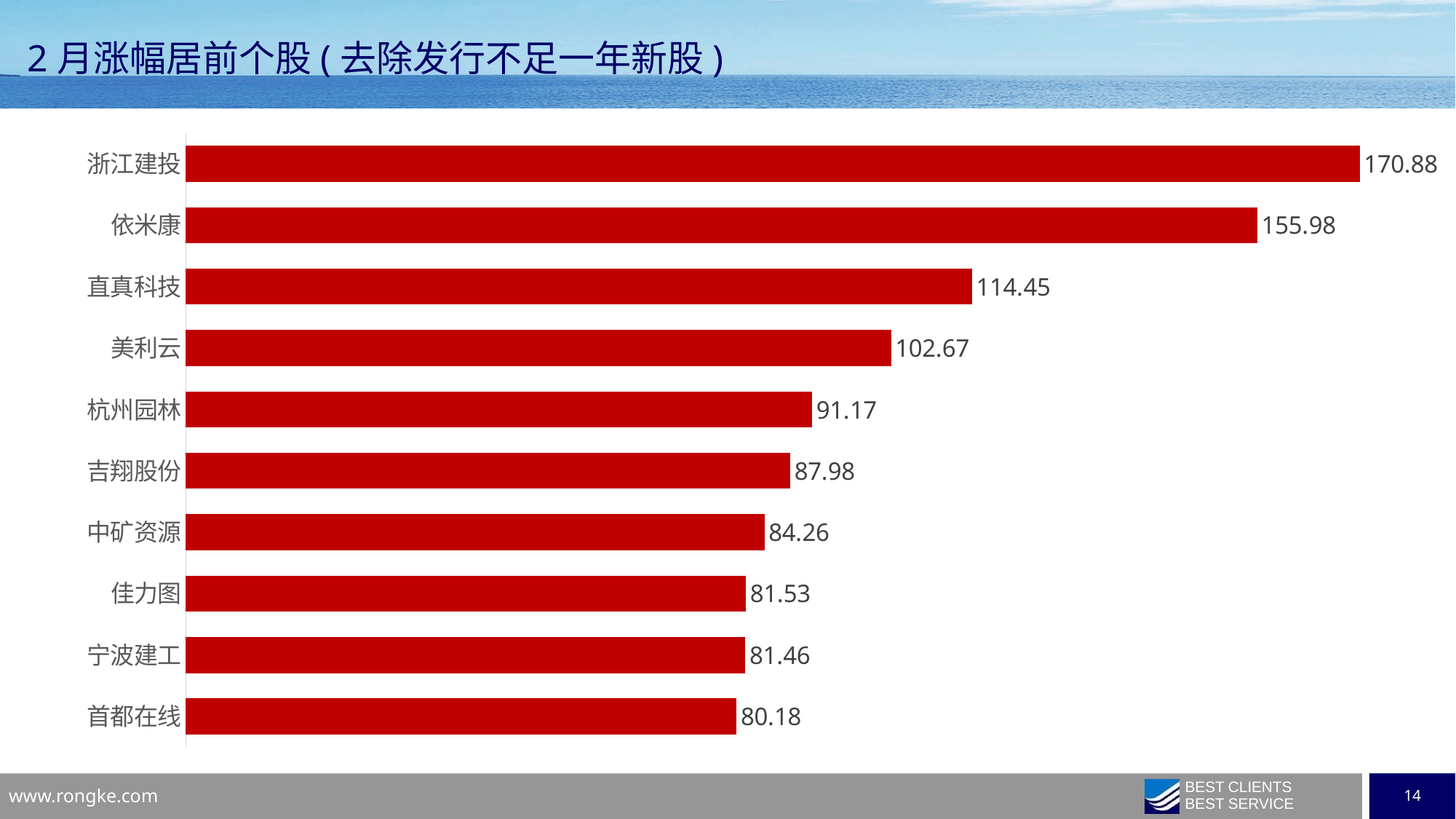
Which stock has the highest value? 浙江建投 What is the value for 浙江建投? 170.88 What is the title of the slide? 2月涨幅居前个股(去除发行不足一年新股) What is the difference between the values for 浙江建投 and 依米康? 14.90 What kind of chart is shown on the slide? Bar chart How many stocks are shown in the chart? 10 Which stock has the lowest value? 首都在线 Which is larger, the value for 杭州园林 or the value for 吉翔股份? 杭州园林 What is the value for 首都在线? 80.18 What is the value for 美利云? 102.67 What is the difference between the values for 直真科技 and 美利云? 11.78 What colour are the bars in the chart? Red